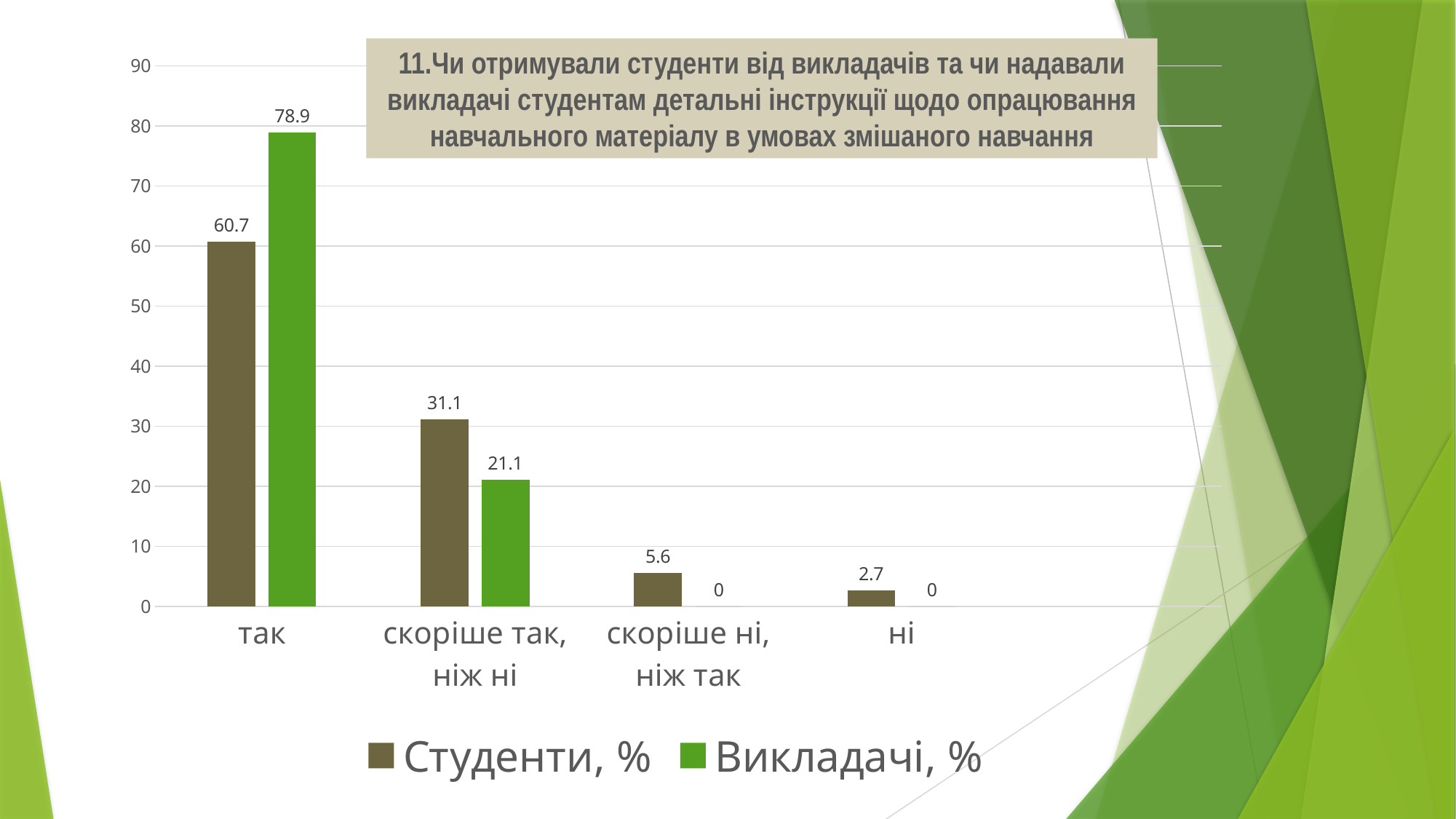
Which category has the highest value for Студенти, %? так Do the values for Студенти, % rise or fall from left to right along the x axis? fall What is the value for Студенти, % in the category так? 60.7 How many series does the legend list? 2 What is the value for Викладачі, % in the category скоріше ні, ніж так? 0 What is the value for Студенти, % in the category скоріше так, ніж ні? 31.1 What kind of chart is shown on the slide? bar chart Which category has the lowest value for Студенти, %? ні What is the value for Викладачі, % in the category так? 78.9 How many categories are shown on the x axis? 4 What is the difference between the Викладачі, % and Студенти, % values in the category так? 18.2 In the category скоріше так, ніж ні, which series has the larger value: Студенти, % or Викладачі, %? Студенти, %